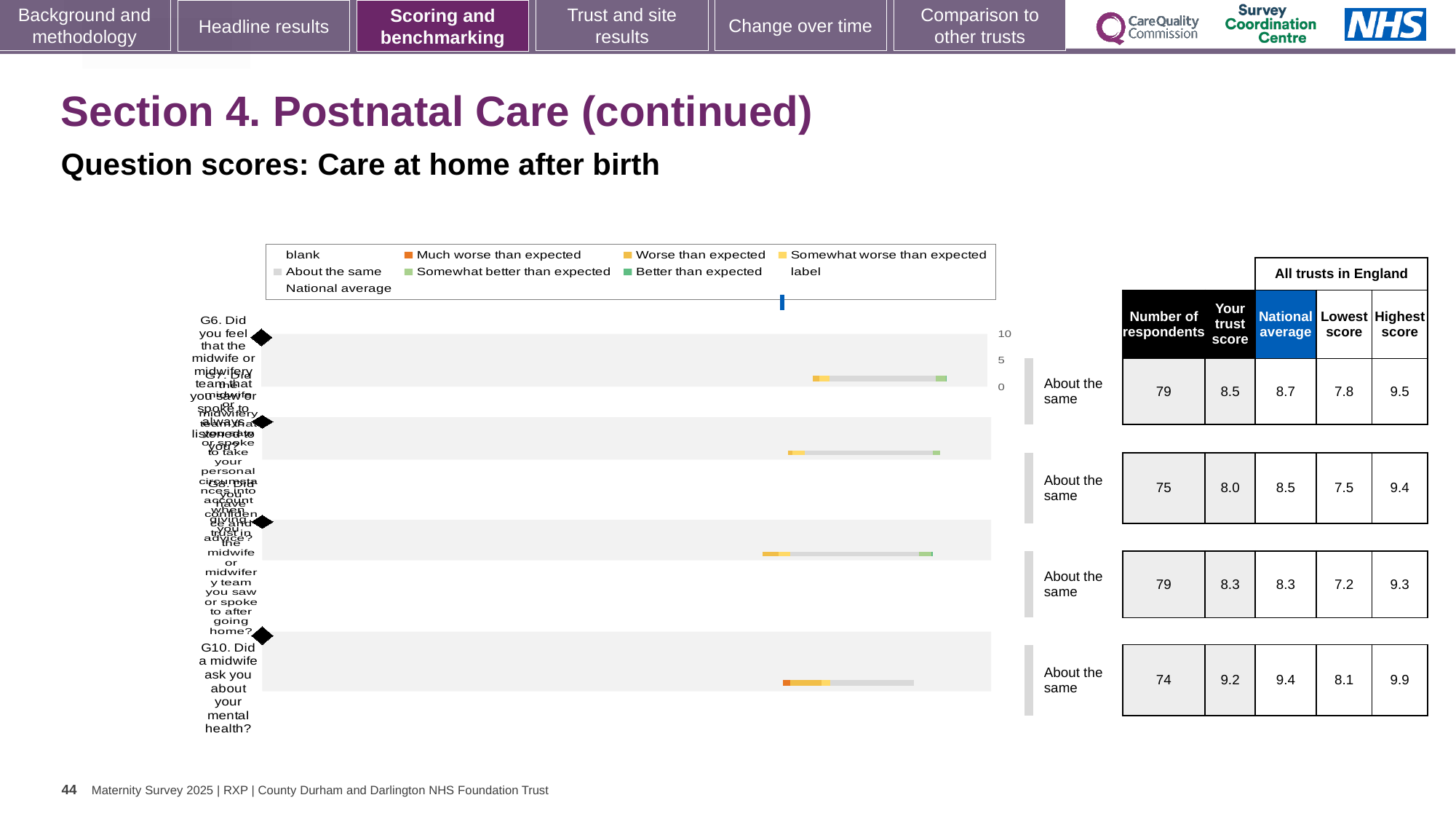
What is the national average for G10 (Did a midwife ask you about your mental health?)? 9.4 How many respondents are listed for G10 (Did a midwife ask you about your mental health?)? 74 What is the subtitle describing the chart's content? Question scores: Care at home after birth What is the lowest 'Your trust score' shown in the table? 8.0 For G10, which is larger: the trust score or the national average? National average What is the highest score across all trusts in England for the first row (G6)? 9.5 What is the difference between the highest score and the lowest score for G10? 1.8 Which question row has the highest 'Your trust score'? G10 What is the 'Your trust score' for G10 (Did a midwife ask you about your mental health?)? 9.2 What benchmark category is shown for G10? About the same How many survey questions (rows) are plotted in the chart? 4 What kind of chart is shown on the slide? bar chart